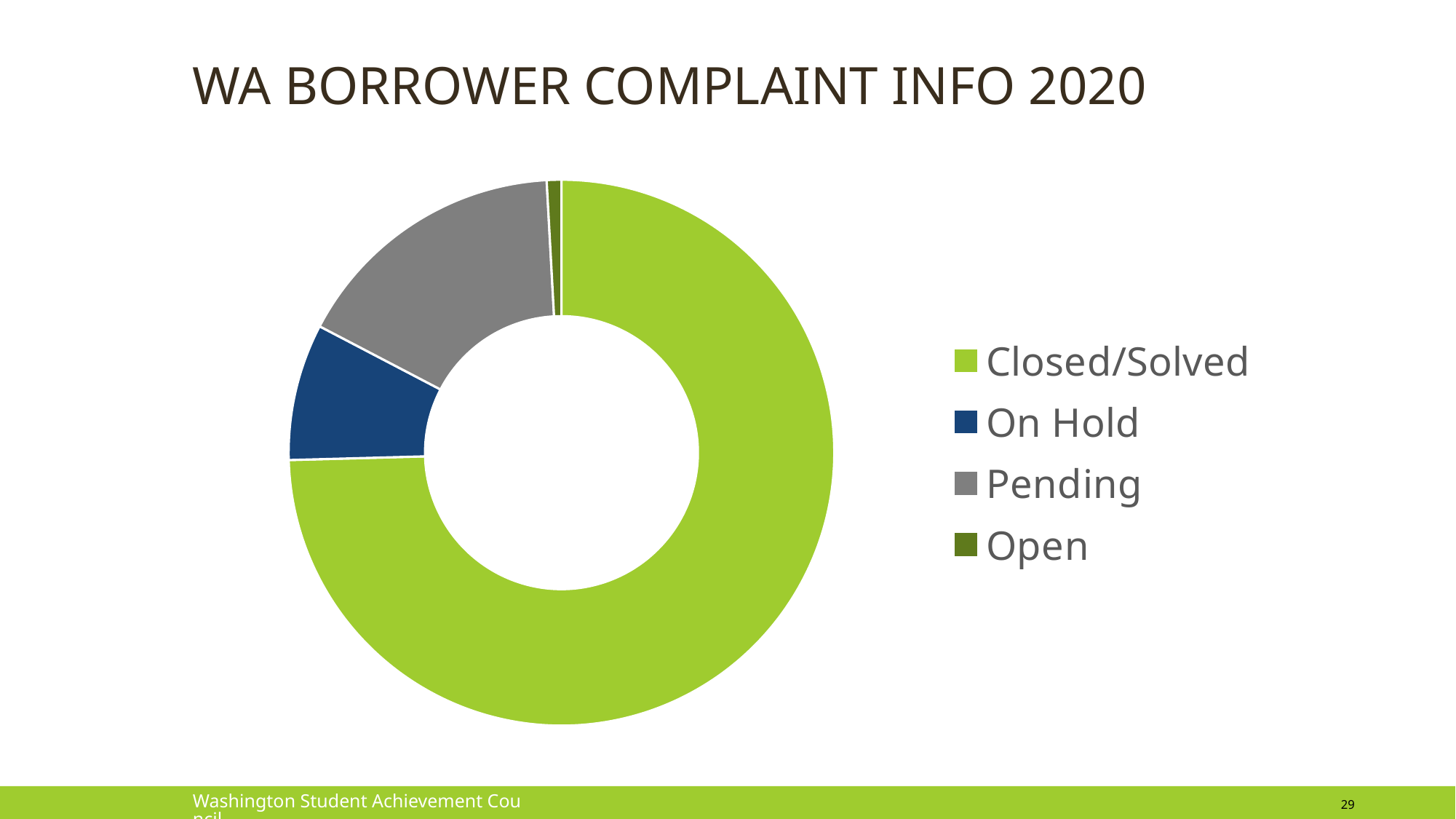
Does the Closed/Solved slice make up more or less than half of the chart? more Which category has the largest share of the chart? Closed/Solved Which is larger, the On Hold slice or the Open slice? On Hold What kind of chart is shown on the slide? doughnut chart Which is larger, the Closed/Solved slice or the Pending slice? Closed/Solved What colour represents the On Hold category in the chart? blue How many categories does the chart show? 4 What is the title of the slide containing the chart? WA BORROWER COMPLAINT INFO 2020 Which category has the smallest share of the chart? Open